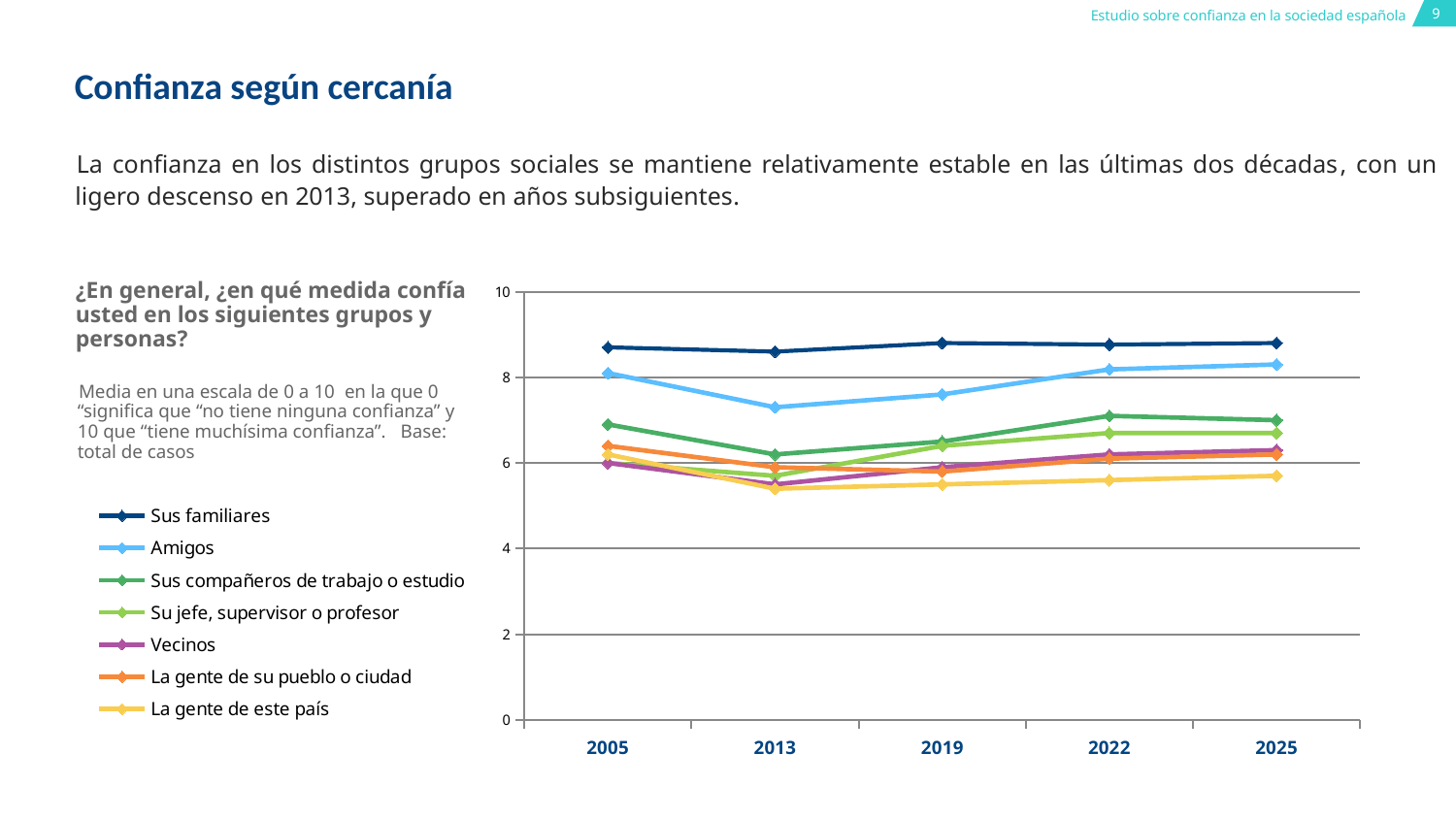
In 2013, which is larger: the value for Sus familiares or the value for Amigos? Sus familiares Which group has the lowest confidence value in 2025? La gente de este país Is the value for Sus familiares in 2005 greater or less than 8? greater How many series does the legend list? 7 Is the value for Amigos in 2013 greater or less than 8? less Is the value for Sus compañeros de trabajo o estudio in 2022 greater or less than 6? greater Which group has the highest confidence value in 2025? Sus familiares Does the value for Amigos rise or fall from 2005 to 2013? fall Which year is the first one shown on the x axis? 2005 How many years are shown on the x axis? 5 What kind of chart is shown on the slide? Line chart